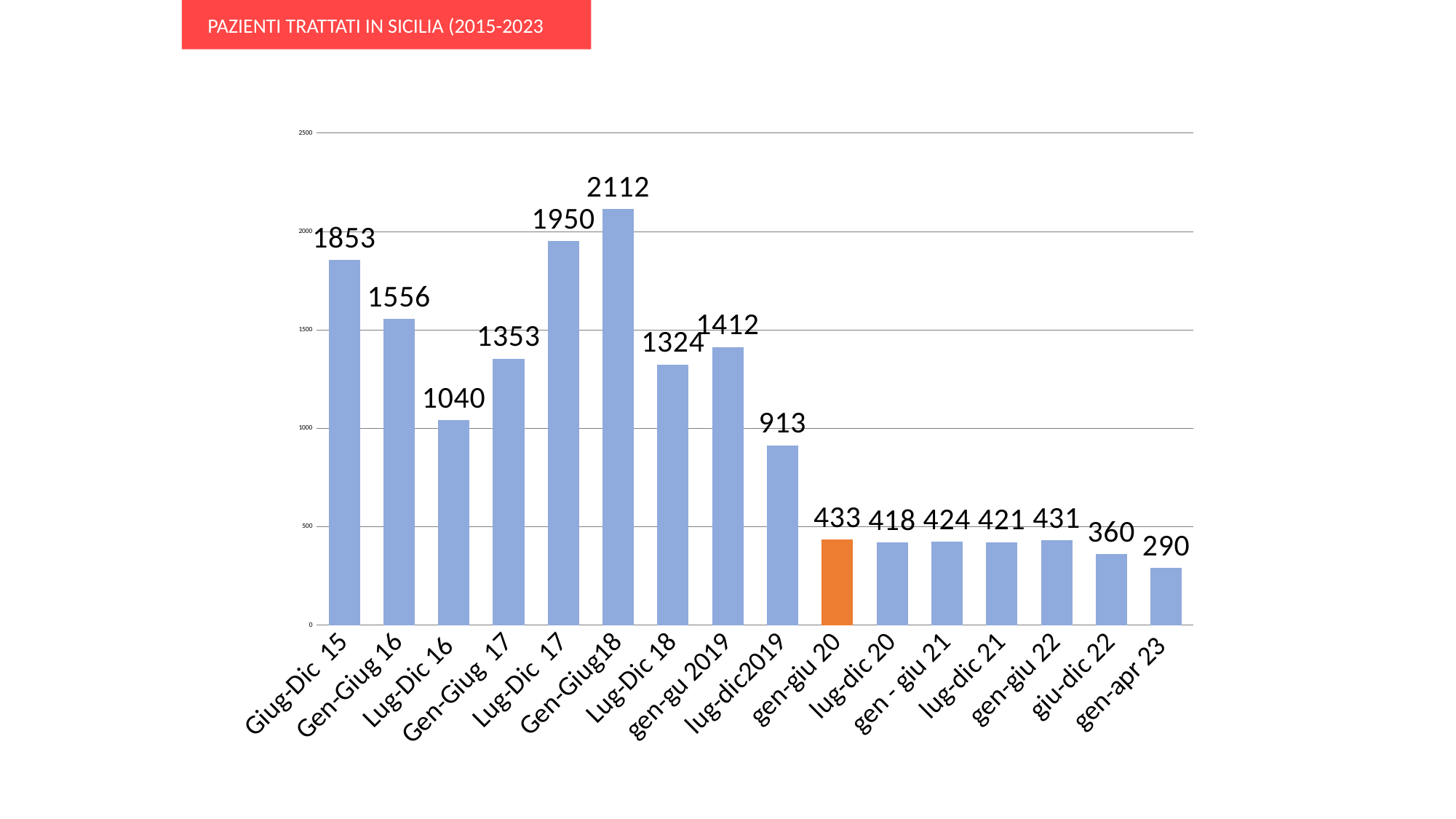
What is the value for lug-dic2019? 913 Which category has the highest value? Gen-Giug18 Which bar is coloured orange instead of blue? gen-giu 20 Is the value for Lug-Dic 18 greater or less than 1000? greater What is the difference between the values for Gen-Giug18 and Lug-Dic 17? 162 What is the value for Gen-Giug18? 2112 Which is larger, the value for Giug-Dic 15 or the value for Gen-Giug 16? Giug-Dic 15 What is the title of the slide? PAZIENTI TRATTATI IN SICILIA (2015-2023 What kind of chart is shown on the slide? bar chart What is the value for gen-giu 20? 433 How many categories are shown on the x axis? 16 Which category has the lowest value? gen-apr 23